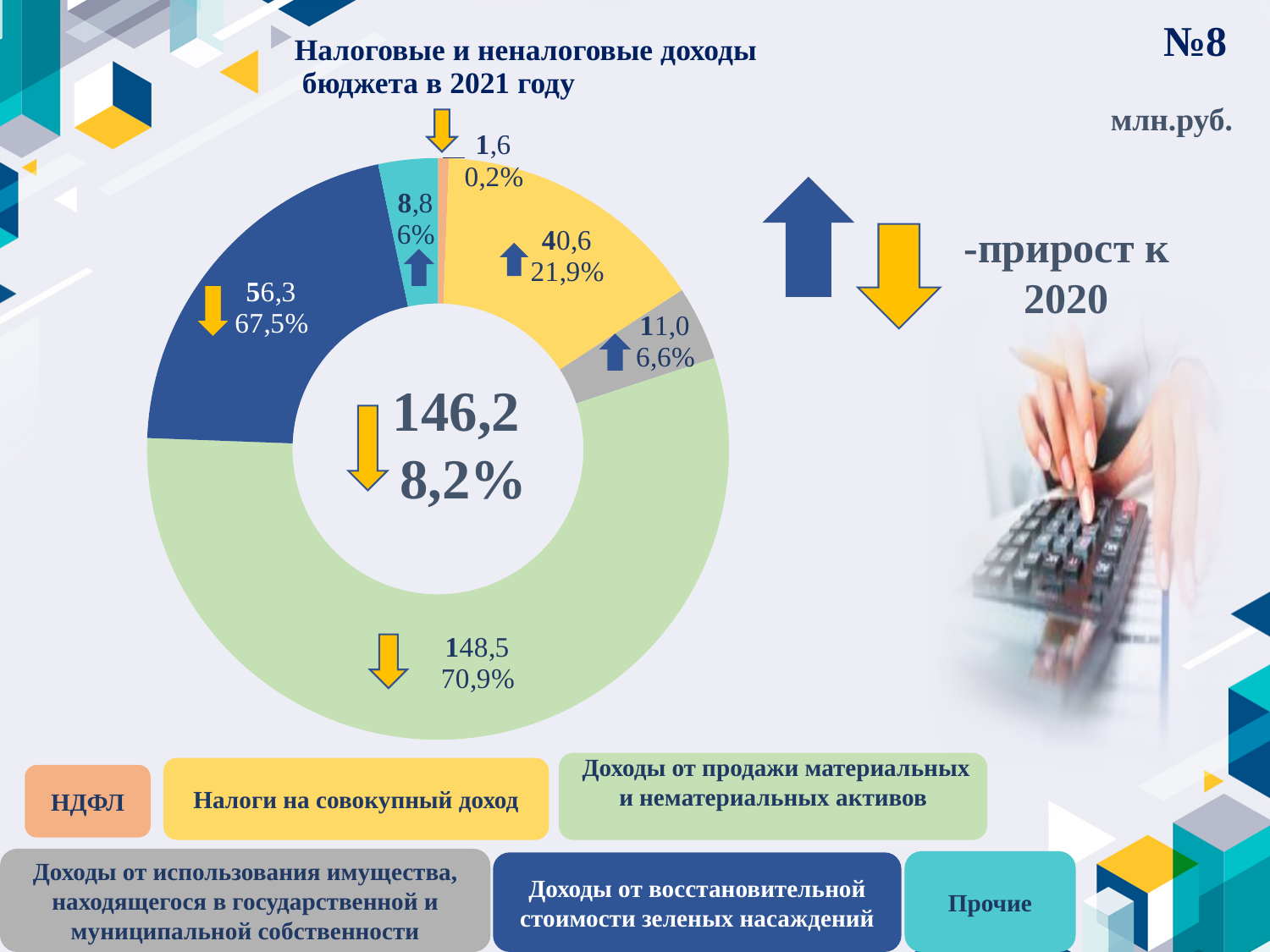
What value (млн.руб.) is shown for Прочие? 8,8 What value (млн.руб.) is shown for Доходы от восстановительной стоимости зеленых насаждений? 56,3 What value (млн.руб.) is shown for Доходы от продажи материальных и нематериальных активов? 148,5 What value (млн.руб.) is shown for Налоги на совокупный доход? 40,6 How many categories does the legend of the chart list? 6 Which category has the smallest slice of the chart? НДФЛ What is the title of the chart? Налоговые и неналоговые доходы бюджета в 2021 году Which category has the largest slice of the chart? Доходы от продажи материальных и нематериальных активов Which is larger: the value for Налоги на совокупный доход or the value for Доходы от использования имущества, находящегося в государственной и муниципальной собственности? Налоги на совокупный доход What value (млн.руб.) is shown for НДФЛ? 1,6 What type of chart is shown on the slide? doughnut chart What total value (млн.руб.) is printed in the centre of the chart? 146,2